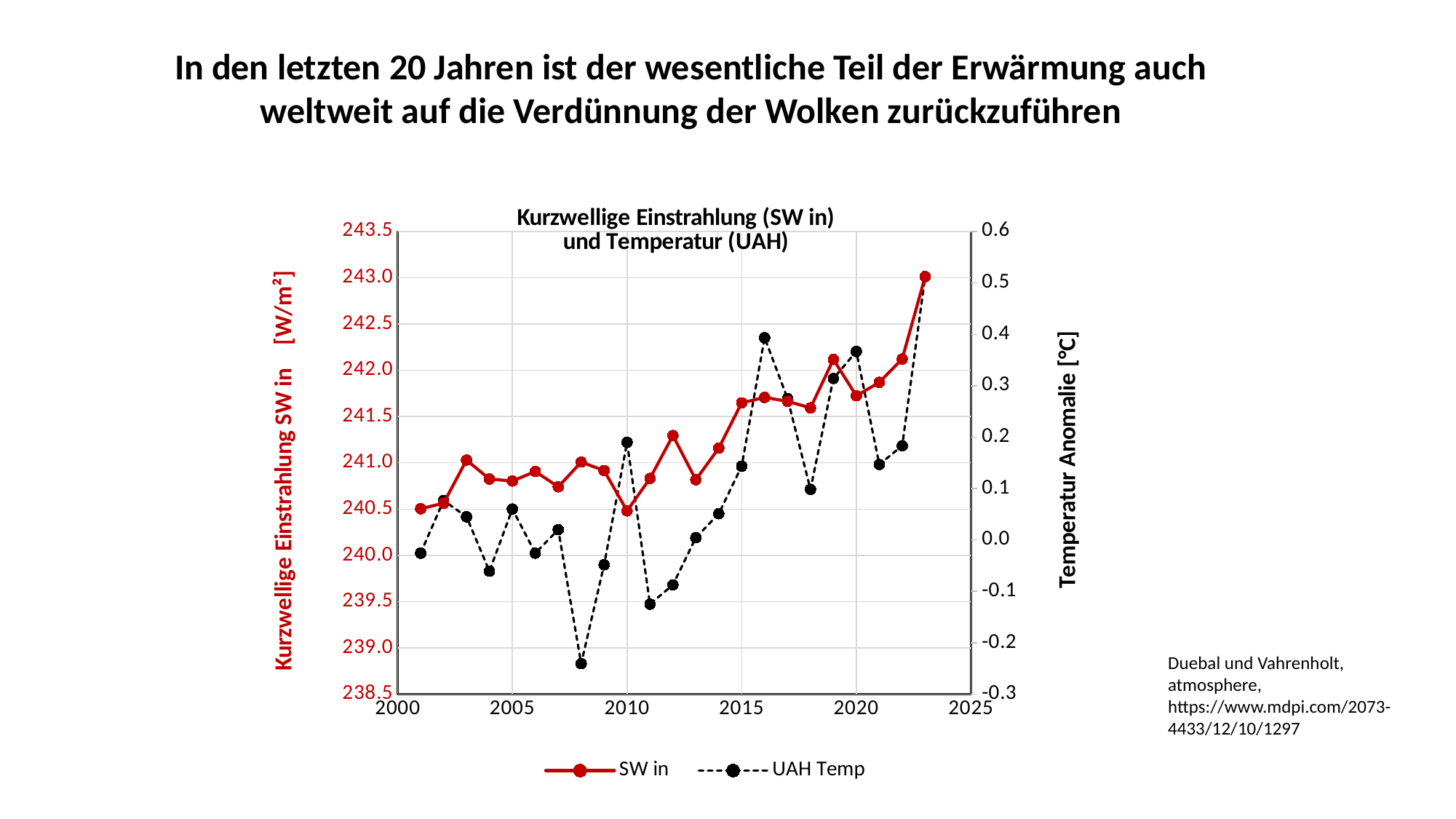
In which year does the SW in series reach its highest value? 2023 What kind of chart is shown on the slide? line chart Is the SW in value for 2023 greater or less than 242.5? greater What are the two series named in the legend? SW in and UAH Temp In which year does the UAH Temp series reach its highest value? 2023 Is the UAH Temp value for 2008 greater or less than -0.2? less How many series does the legend list? 2 In which year does the UAH Temp series reach its lowest value? 2008 Overall, does the SW in series rise or fall from 2001 to 2023? rise Which year has the higher SW in value, 2012 or 2013? 2012 What is the title of the chart? Kurzwellige Einstrahlung (SW in) und Temperatur (UAH) Is the UAH Temp value for 2016 greater or less than 0.3? greater